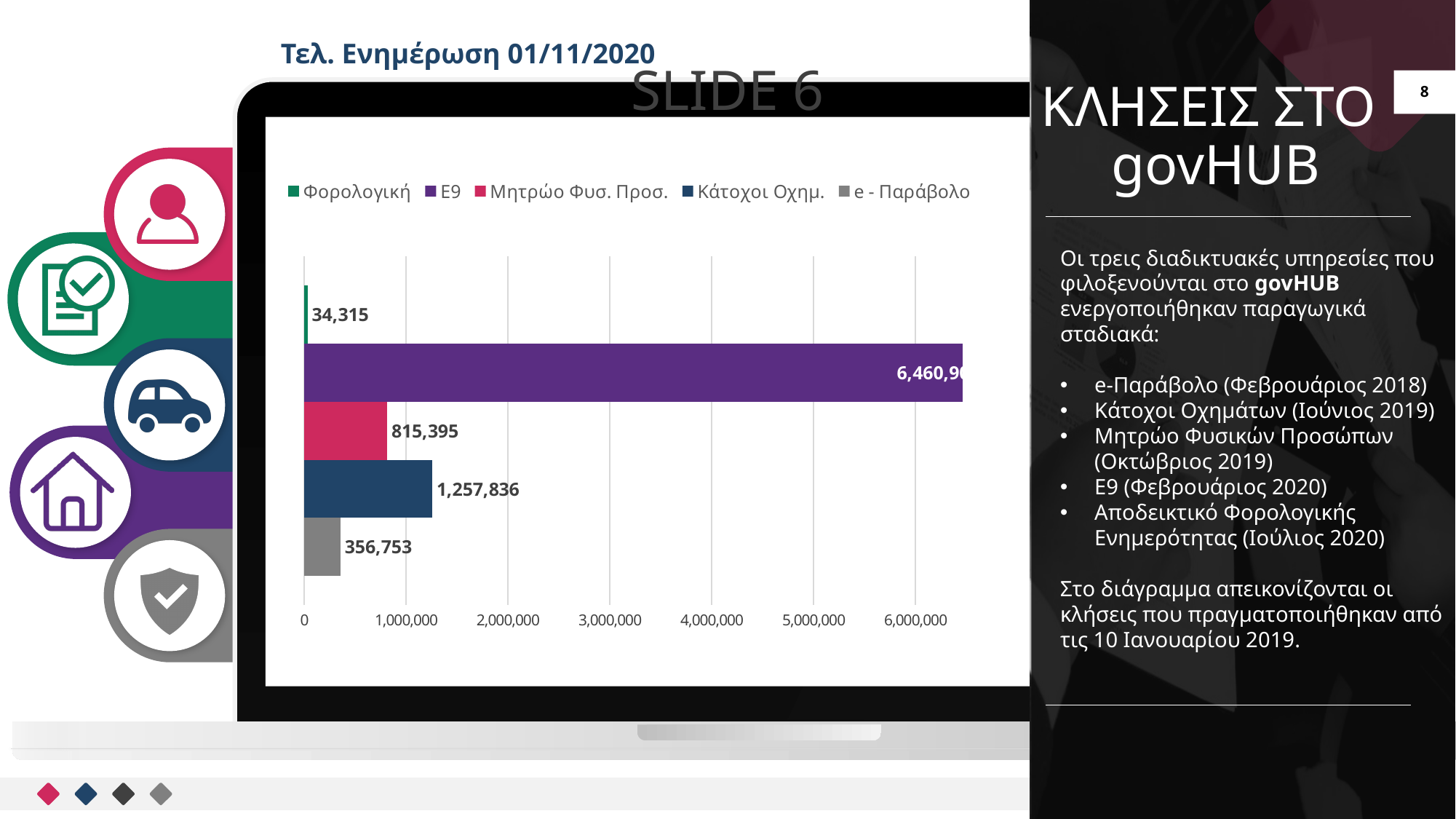
What is the value for Φορολογική? 34,315 What is the value for Μητρώο Φυσ. Προσ.? 815,395 What is the value for Κάτοχοι Οχημ.? 1,257,836 Which is larger, the value for Μητρώο Φυσ. Προσ. or the value for e - Παράβολο? Μητρώο Φυσ. Προσ. What is the difference between the values for Κάτοχοι Οχημ. and Μητρώο Φυσ. Προσ.? 442,441 What kind of chart is shown on the slide? bar chart What is the difference between the values for e - Παράβολο and Φορολογική? 322,438 Which series has the highest value? E9 Which series has the lowest value? Φορολογική How many series does the legend list? 5 Is the value for E9 greater or less than 6,000,000? greater What is the value for e - Παράβολο? 356,753